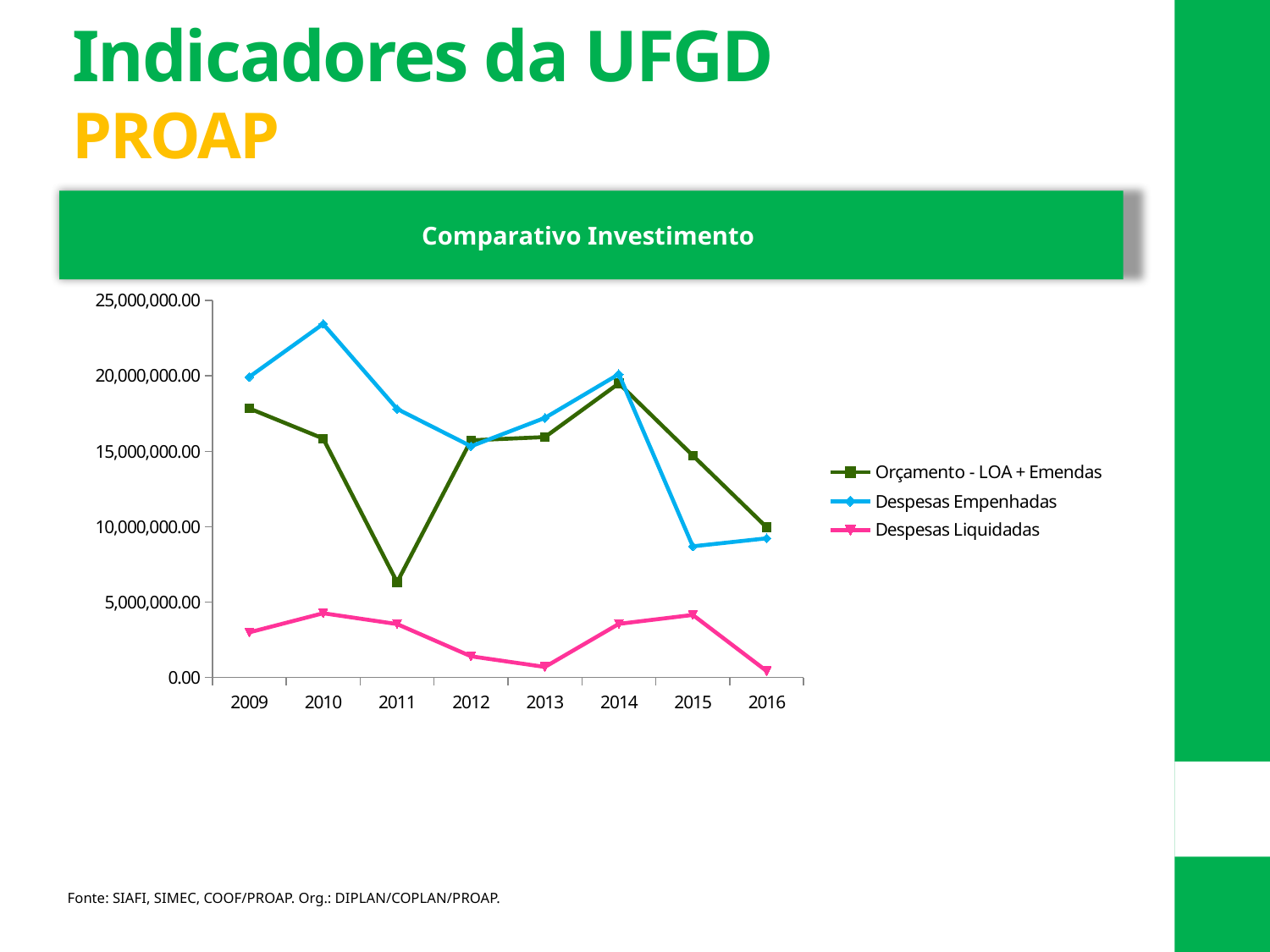
Is the value for "Despesas Empenhadas" in 2015 greater or less than 10,000,000.00? less How many years are shown on the x axis of the chart? 8 What kind of chart is shown under the title "Comparativo Investimento"? Line chart How many series does the legend of the chart list? 3 In which year does the "Despesas Empenhadas" series reach its highest value? 2010 In which year does the "Orçamento - LOA + Emendas" series reach its lowest value? 2011 Which series is drawn in pink in the chart? Despesas Liquidadas Does the "Orçamento - LOA + Emendas" series rise or fall from 2014 to 2016? Fall In 2009, which series has the larger value: "Despesas Empenhadas" or "Orçamento - LOA + Emendas"? Despesas Empenhadas Is the value for "Orçamento - LOA + Emendas" in 2011 greater or less than 10,000,000.00? less Is the value for "Despesas Empenhadas" in 2010 greater or less than 20,000,000.00? greater